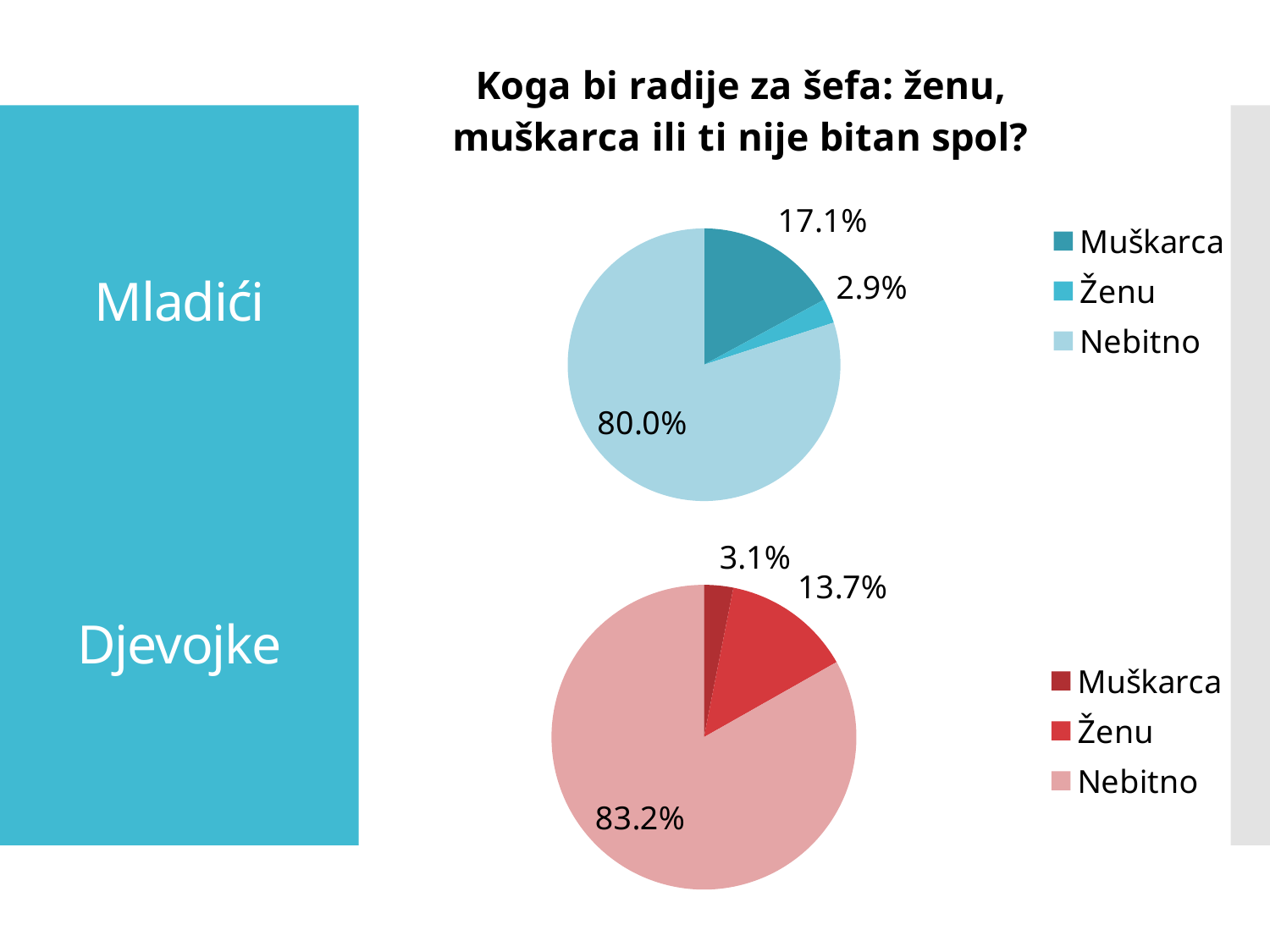
In the top pie chart (Mladići), which category has the smallest slice? Ženu What type of chart is used on this slide? Pie chart In the top pie chart (Mladići), what share of respondents chose Muškarca? 17.1% In the top pie chart (Mladići), what share of respondents chose Ženu? 2.9% In the top pie chart (Mladići), what is the difference between the Muškarca and Ženu shares? 14.2% In the bottom pie chart (Djevojke), which category has the largest slice? Nebitno How many slices does the bottom pie chart (Djevojke) have? 3 In the bottom pie chart (Djevojke), what share of respondents chose Ženu? 13.7% What is the title shown above the charts? Koga bi radije za šefa: ženu, muškarca ili ti nije bitan spol? In the top pie chart (Mladići), what share of respondents chose Nebitno? 80.0% Which is larger: the Nebitno share in the top chart (Mladići) or the Nebitno share in the bottom chart (Djevojke)? Djevojke (83.2%) In the bottom pie chart (Djevojke), what share of respondents chose Muškarca? 3.1%